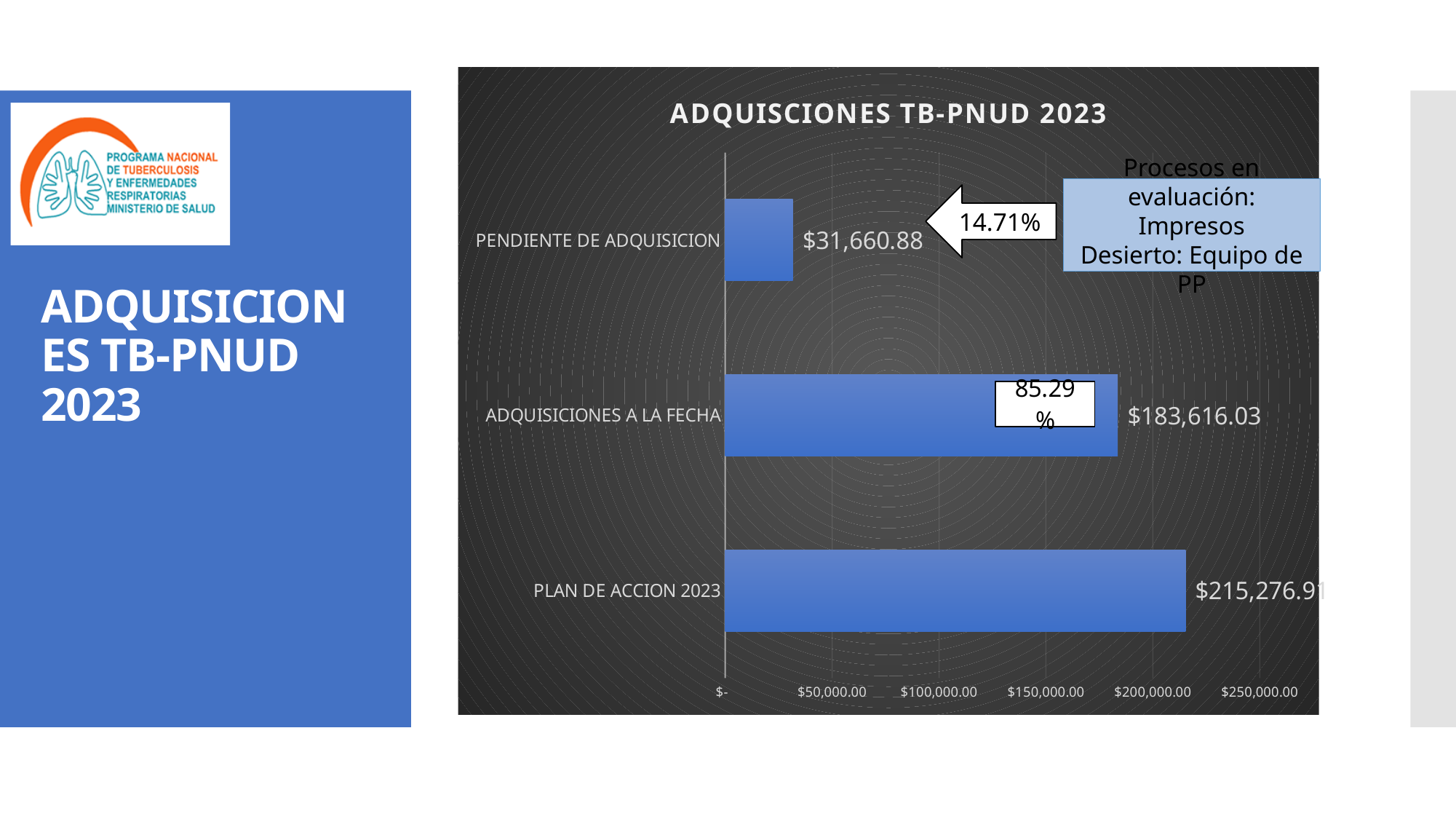
How many categories are shown in the chart? 3 What kind of chart is shown on the slide? bar chart Which is larger, ADQUISICIONES A LA FECHA or PENDIENTE DE ADQUISICION? ADQUISICIONES A LA FECHA What is the difference between PLAN DE ACCION 2023 and ADQUISICIONES A LA FECHA? $31,660.88 What is the value for PENDIENTE DE ADQUISICION? $31,660.88 Is the value for ADQUISICIONES A LA FECHA greater or less than $200,000.00? less What is the difference between ADQUISICIONES A LA FECHA and PENDIENTE DE ADQUISICION? $151,955.15 What is the value for PLAN DE ACCION 2023? $215,276.91 Which category has the highest value? PLAN DE ACCION 2023 Which category has the lowest value? PENDIENTE DE ADQUISICION What is the value for ADQUISICIONES A LA FECHA? $183,616.03 What percentage is shown in the arrow annotation next to the PENDIENTE DE ADQUISICION bar? 14.71%